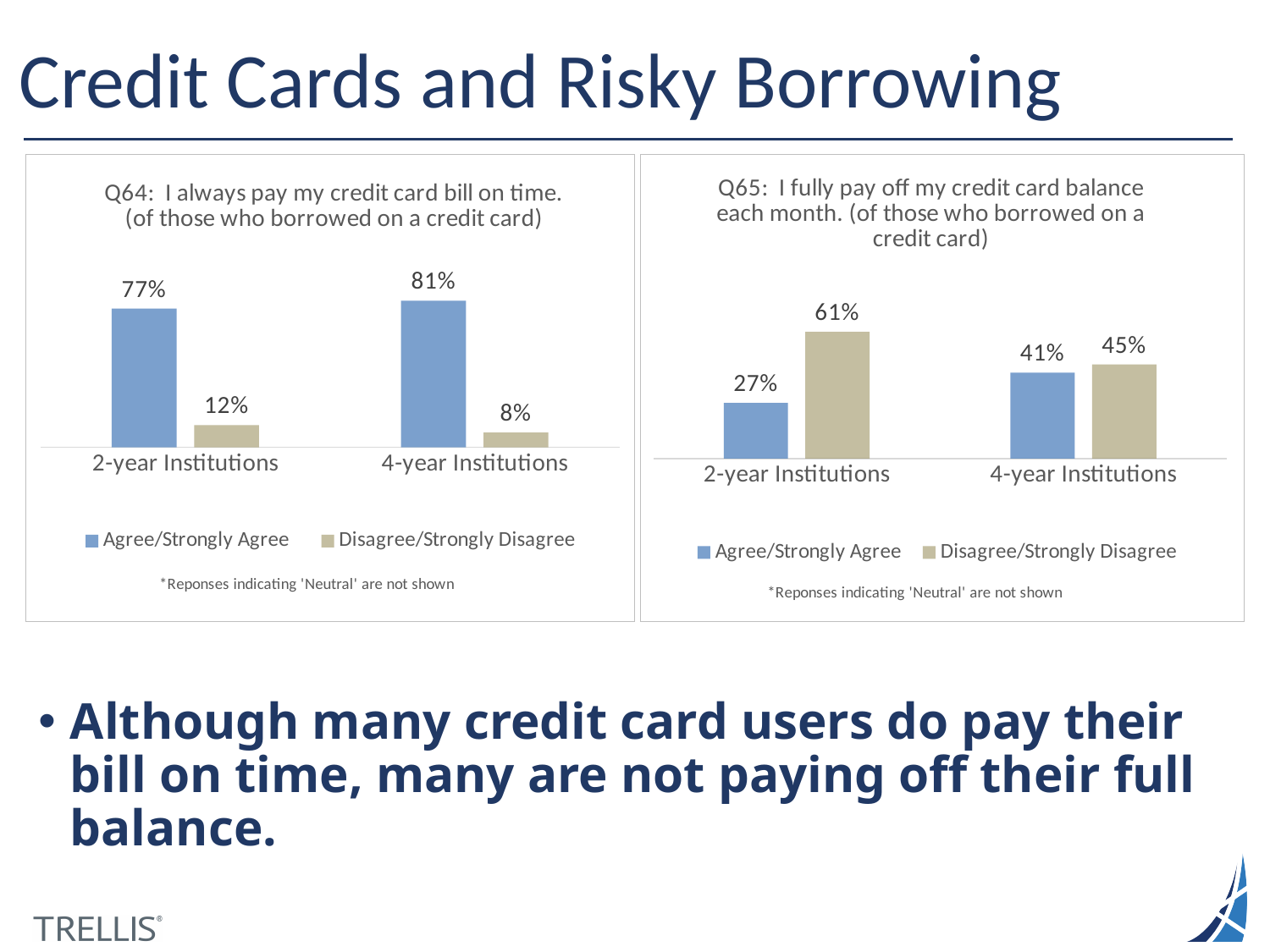
In the Q64 chart (left), what is the Disagree/Strongly Disagree value for 4-year Institutions? 8% In the Q64 chart (left), which institution type has the lowest Disagree/Strongly Disagree value? 4-year Institutions In the Q64 chart (left), what is the difference between the Agree/Strongly Agree values for 4-year and 2-year Institutions? 4% In the Q65 chart (right), which bar has the highest value? Disagree/Strongly Disagree for 2-year Institutions (61%) How many series does the legend of the Q64 chart (left) list? 2 According to the note below the Q64 chart (left), which responses are not shown? Responses indicating 'Neutral' In the Q64 chart (left), what percentage of 2-year Institutions respondents Agree/Strongly Agree that they always pay their credit card bill on time? 77% In the Q65 chart (right), what is the Disagree/Strongly Disagree value for 2-year Institutions? 61% What kind of chart is the Q65 chart (right)? Bar chart In the Q65 chart (right), what is the Agree/Strongly Agree value for 4-year Institutions? 41% In the Q65 chart (right), what is the difference between the Disagree/Strongly Disagree and Agree/Strongly Agree values for 2-year Institutions? 34% In the Q65 chart (right), which is larger for 4-year Institutions: Agree/Strongly Agree or Disagree/Strongly Disagree? Disagree/Strongly Disagree